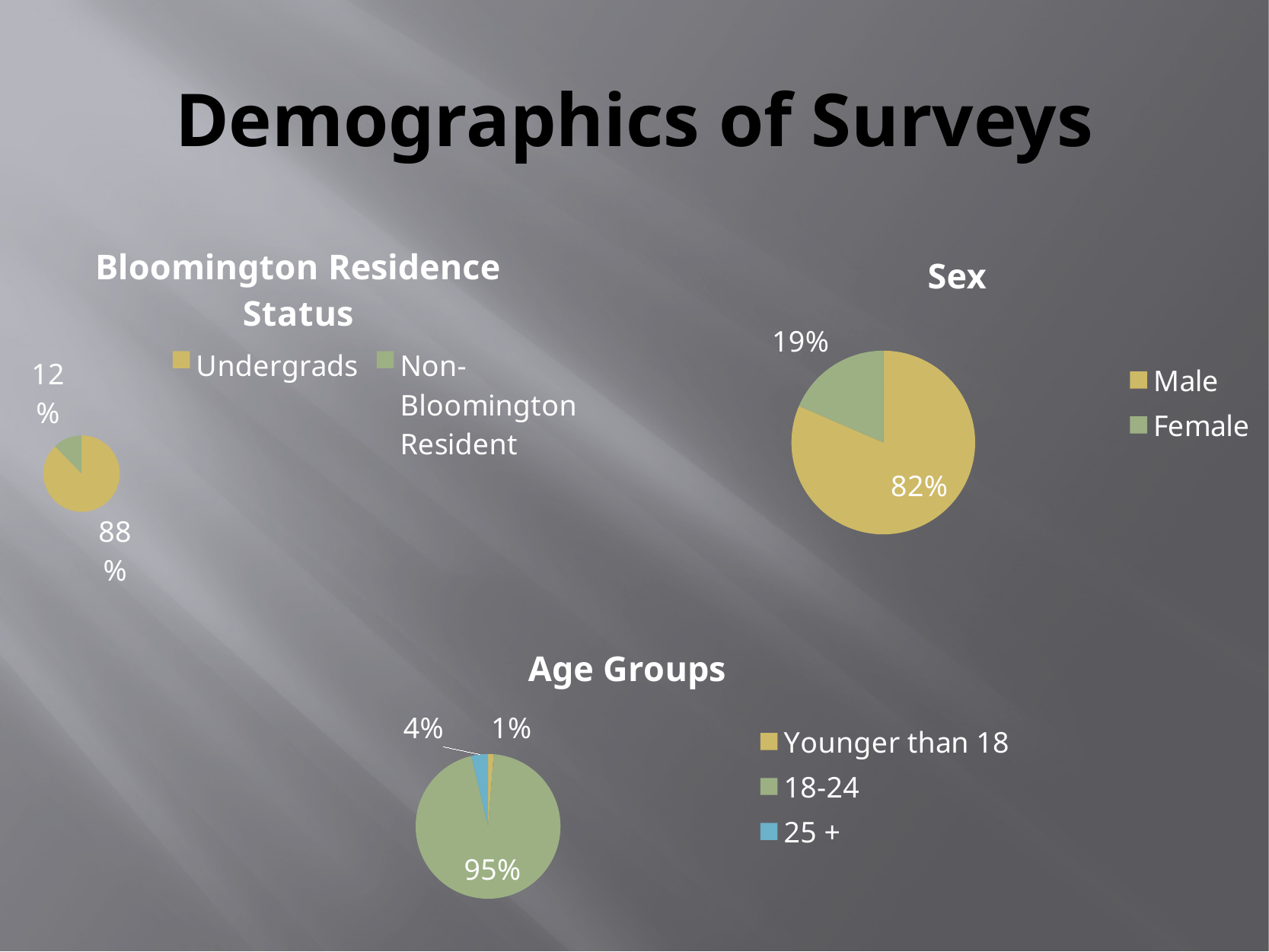
In the Bloomington Residence Status chart, what colour is the Undergrads slice? Yellow In the Age Groups chart, what is the difference between the 18-24 share and the 25 + share? 91% In the Age Groups chart, which category has the smallest slice? Younger than 18 In the Bloomington Residence Status chart, what share of the pie is Non-Bloomington Resident? 12% In the Age Groups chart, how many categories does the legend list? 3 In the Sex chart, what percentage is labelled for Female? 19% In the Bloomington Residence Status chart, what share of the pie is Undergrads? 88% In the Sex chart, which category has the larger slice? Male In the Age Groups chart, what share of the pie is 18-24? 95% What kind of chart is the Sex chart? Pie chart In the Sex chart, what percentage is labelled for Male? 82%